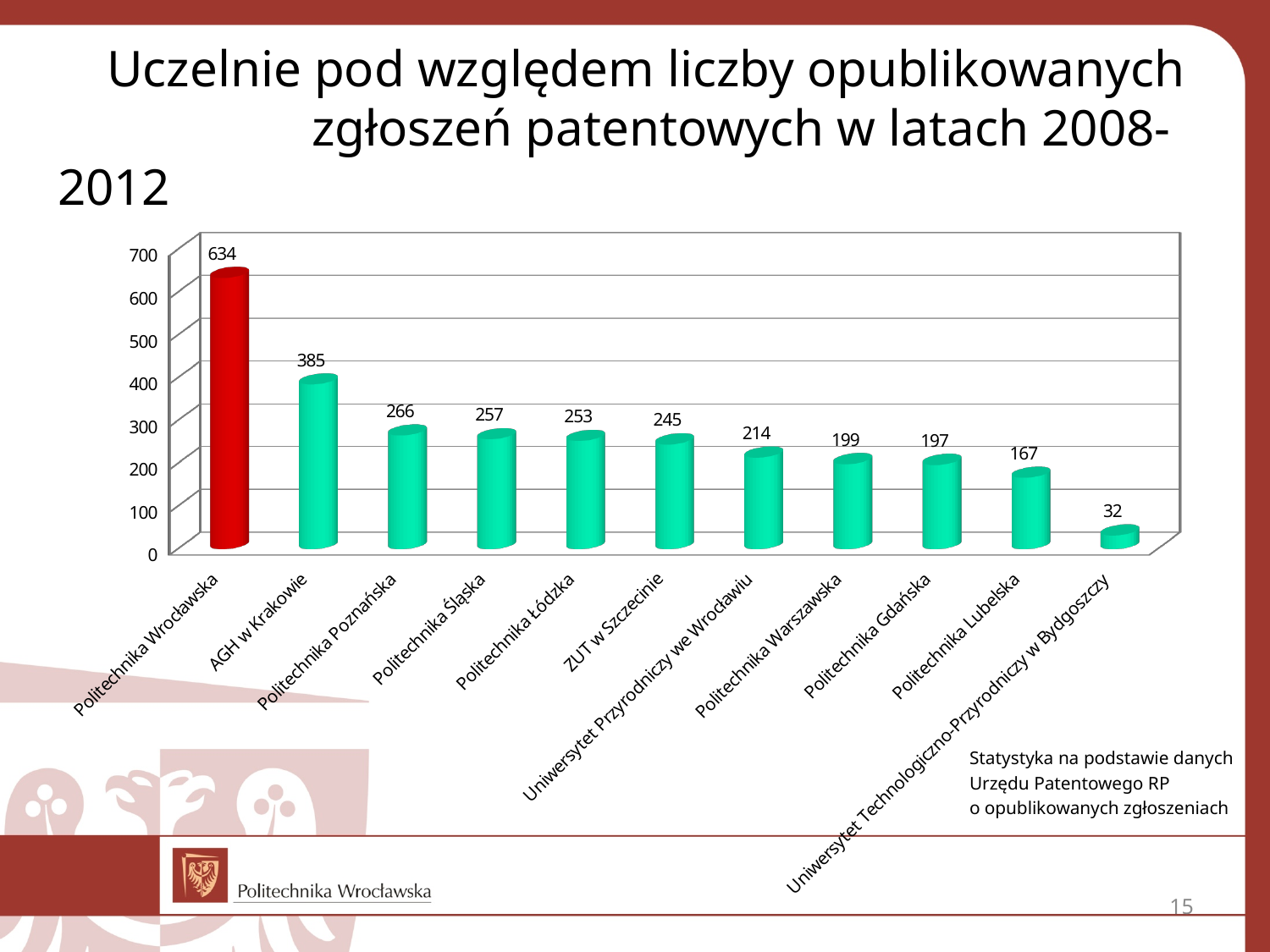
What is the value for Politechnika Lubelska? 167 What is the value for AGH w Krakowie? 385 Do the values rise or fall from left to right along the x axis? fall Which university has the lowest value? Uniwersytet Technologiczno-Przyrodniczy w Bydgoszczy What is the value for Politechnika Wrocławska? 634 What is the value for ZUT w Szczecinie? 245 Which bar is shown in a different colour (red) from the others? Politechnika Wrocławska What kind of chart is shown on the slide? bar chart Which is larger, the value for Politechnika Poznańska or Politechnika Warszawska? Politechnika Poznańska Which university has the highest value? Politechnika Wrocławska How many universities are shown in the chart? 11 What is the difference between the values for Politechnika Wrocławska and AGH w Krakowie? 249